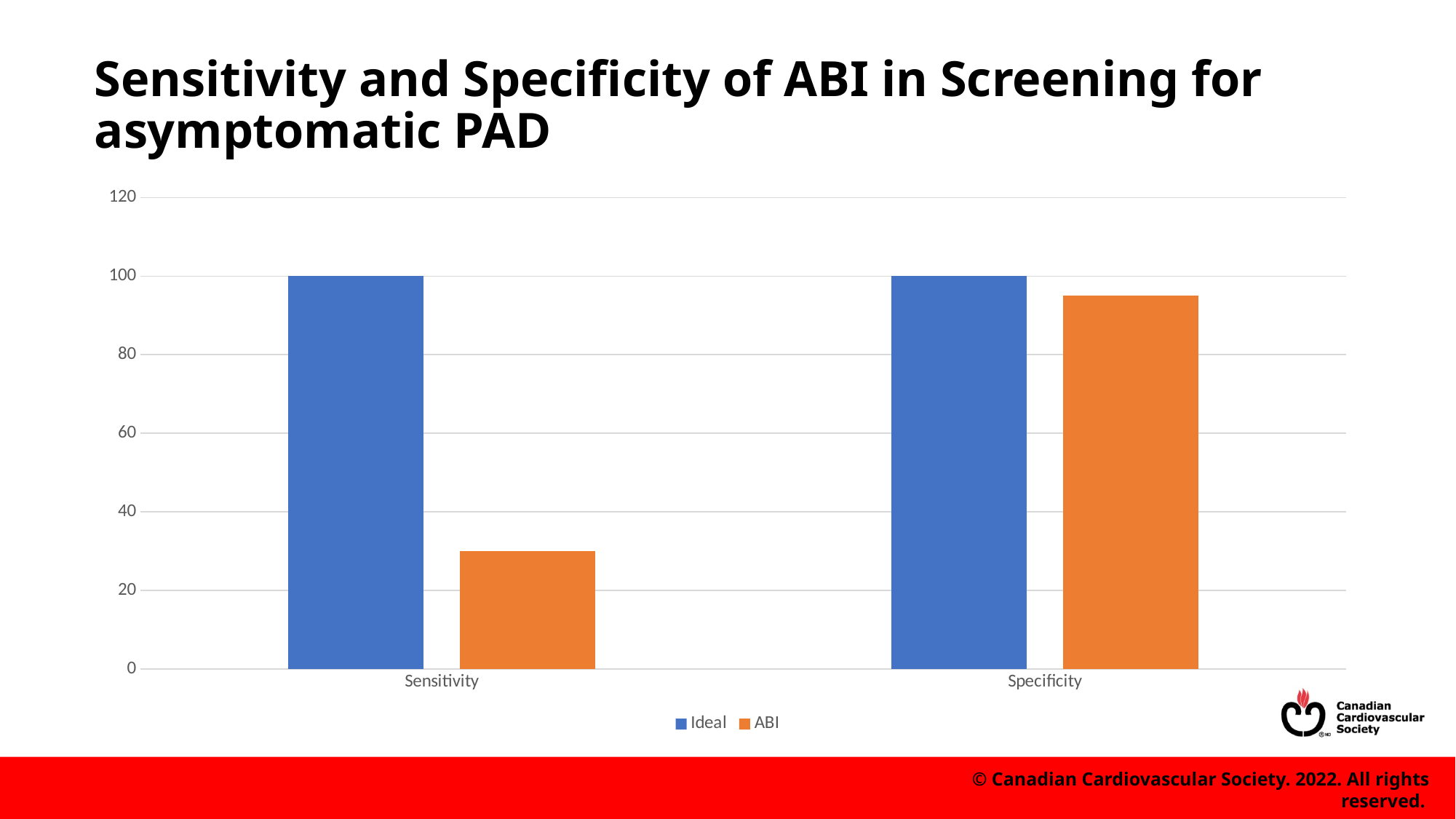
Is the ABI value for Specificity greater or less than 80? greater How many series does the legend list? 2 How many categories are shown on the x axis? 2 For Sensitivity, which series has the lower value? ABI What kind of chart is shown on the slide? bar chart What is the Ideal value for Sensitivity? 100 Which is larger, the ABI value for Sensitivity or the ABI value for Specificity? Specificity What is the Ideal value for Specificity? 100 Is the ABI value for Sensitivity greater or less than 40? less What is the title of the chart? Sensitivity and Specificity of ABI in Screening for asymptomatic PAD Which series is shown in orange? ABI Is the ABI value for Sensitivity greater or less than 20? greater